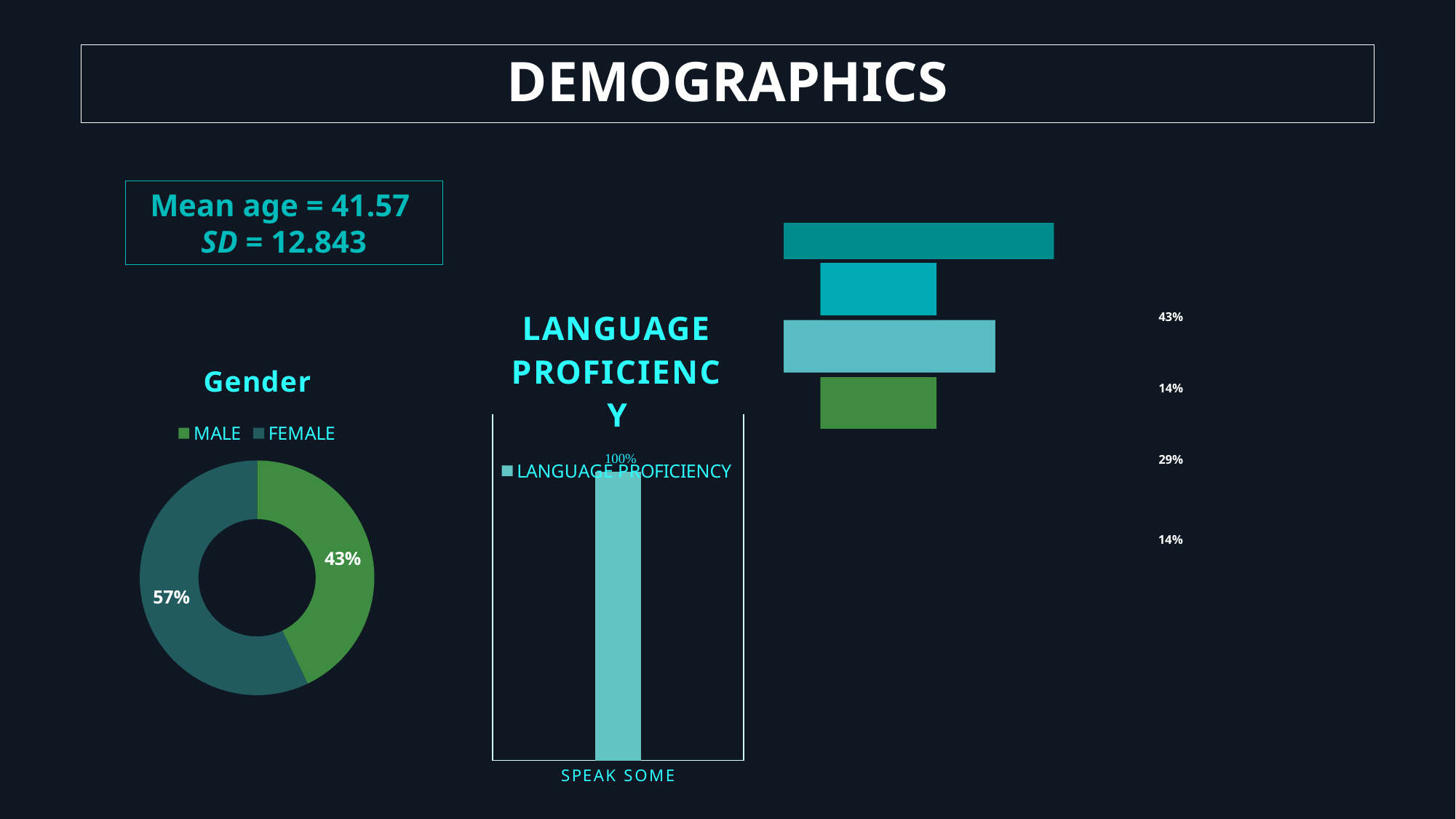
In the Gender chart, what is the difference between the FEMALE and MALE percentages? 14% In the Gender chart, what percentage is FEMALE? 57% In the Gender chart, what percentage is MALE? 43% In the Gender chart, which category has the larger share? FEMALE How many bars does the LANGUAGE PROFICIENCY chart show? 1 How many categories does the Gender chart's legend list? 2 What kind of chart is the LANGUAGE PROFICIENCY chart? bar chart In the Gender chart, which category has the smaller share? MALE In the Gender chart, which colour represents MALE? green In the LANGUAGE PROFICIENCY chart, what is the value for SPEAK SOME? 100% In the Gender chart, is the MALE share larger or smaller than the FEMALE share? smaller What kind of chart is the Gender chart? doughnut chart